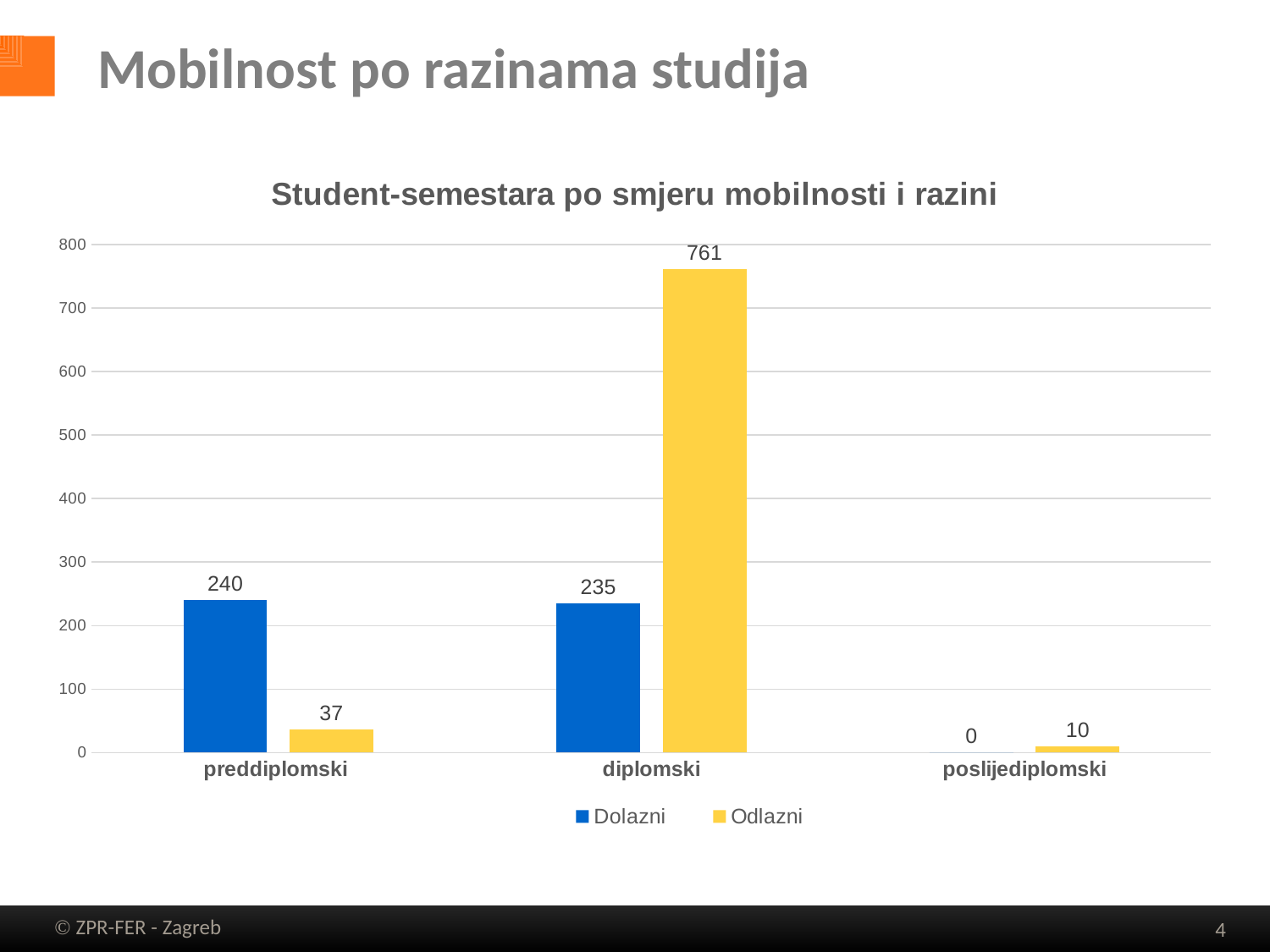
What is the Odlazni value for diplomski? 761 How many series does the legend list? 2 What is the Odlazni value for poslijediplomski? 10 Which category has the lowest Dolazni value? poslijediplomski What is the Dolazni value for preddiplomski? 240 What is the Dolazni value for poslijediplomski? 0 What kind of chart is shown? bar chart What is the difference between the Odlazni and Dolazni values for diplomski? 526 Which is larger for preddiplomski, Dolazni or Odlazni? Dolazni What is the difference between the Dolazni values for preddiplomski and diplomski? 5 How many categories are shown on the x axis? 3 Which category has the highest Odlazni value? diplomski